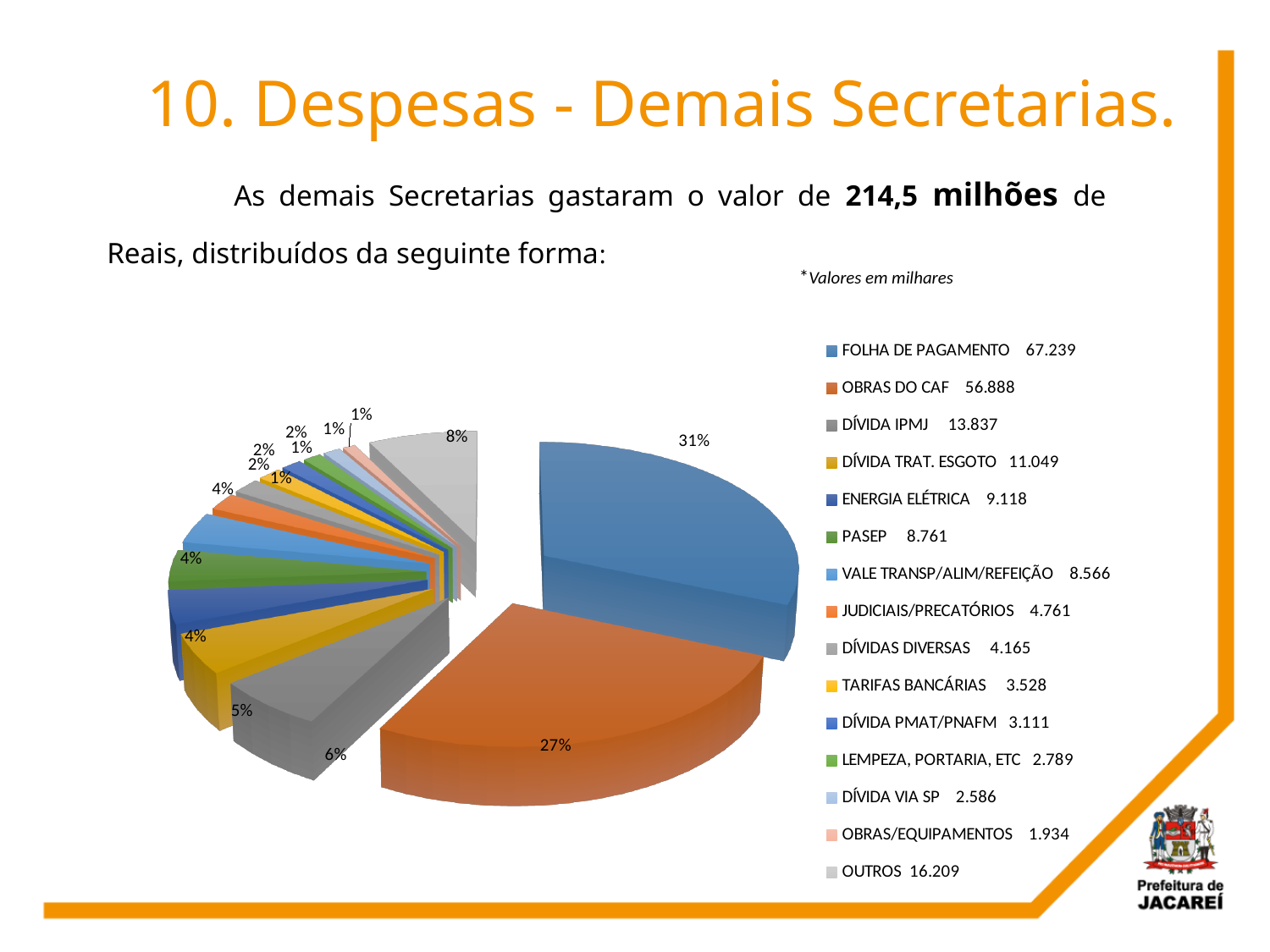
What value is shown in the legend for DÍVIDA IPMJ? 13.837 What share of the pie does OBRAS DO CAF represent? 27% What share of the pie does FOLHA DE PAGAMENTO represent? 31% What is the difference between the legend values for FOLHA DE PAGAMENTO and OBRAS DO CAF? 10.351 Which category has the smallest value in the legend? OBRAS/EQUIPAMENTOS How many categories does the pie chart's legend list? 15 Which category has the largest slice of the pie? FOLHA DE PAGAMENTO What share of the pie does OUTROS represent? 8% According to the note above the legend, in what unit are the values expressed? Valores em milhares What kind of chart is shown on the slide? pie chart What value is shown in the legend for ENERGIA ELÉTRICA? 9.118 Which is larger, the value for DÍVIDA IPMJ or the value for OUTROS? OUTROS